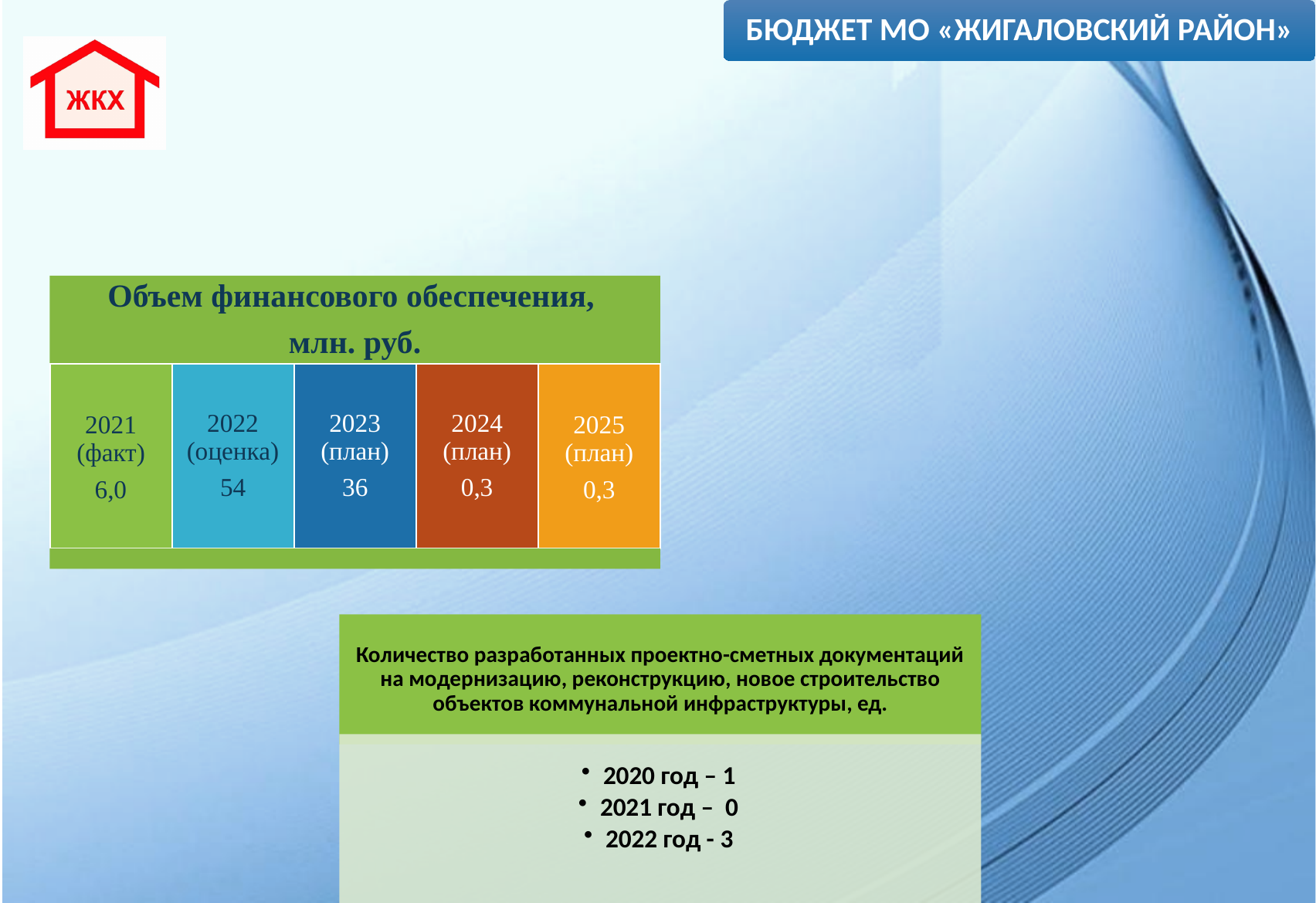
In the 'Объем финансового обеспечения, млн. руб.' chart, what is the difference between the values for 2022 (оценка) and 2021 (факт)? 48 In the 'Объем финансового обеспечения, млн. руб.' chart, which year has the highest value? 2022 (оценка) In the 'Объем финансового обеспечения, млн. руб.' chart, what is the difference between the values for 2022 (оценка) and 2023 (план)? 18 In the 'Объем финансового обеспечения, млн. руб.' chart, what is the value for 2025 (план)? 0,3 In the 'Объем финансового обеспечения, млн. руб.' chart, what is the value for 2022 (оценка)? 54 In the 'Объем финансового обеспечения, млн. руб.' chart, which is larger: the value for 2021 (факт) or 2023 (план)? 2023 (план) In the 'Объем финансового обеспечения, млн. руб.' chart, what is the value for 2021 (факт)? 6,0 What unit is given in the title of the chart on the left of the slide? млн. руб. In the 'Объем финансового обеспечения, млн. руб.' chart, what is the lowest value shown? 0,3 How many years are shown in the 'Объем финансового обеспечения, млн. руб.' chart? 5 In the 'Объем финансового обеспечения, млн. руб.' chart, what is the value for 2023 (план)? 36 In the 'Объем финансового обеспечения, млн. руб.' chart, do the values rise or fall from 2022 to 2025? fall